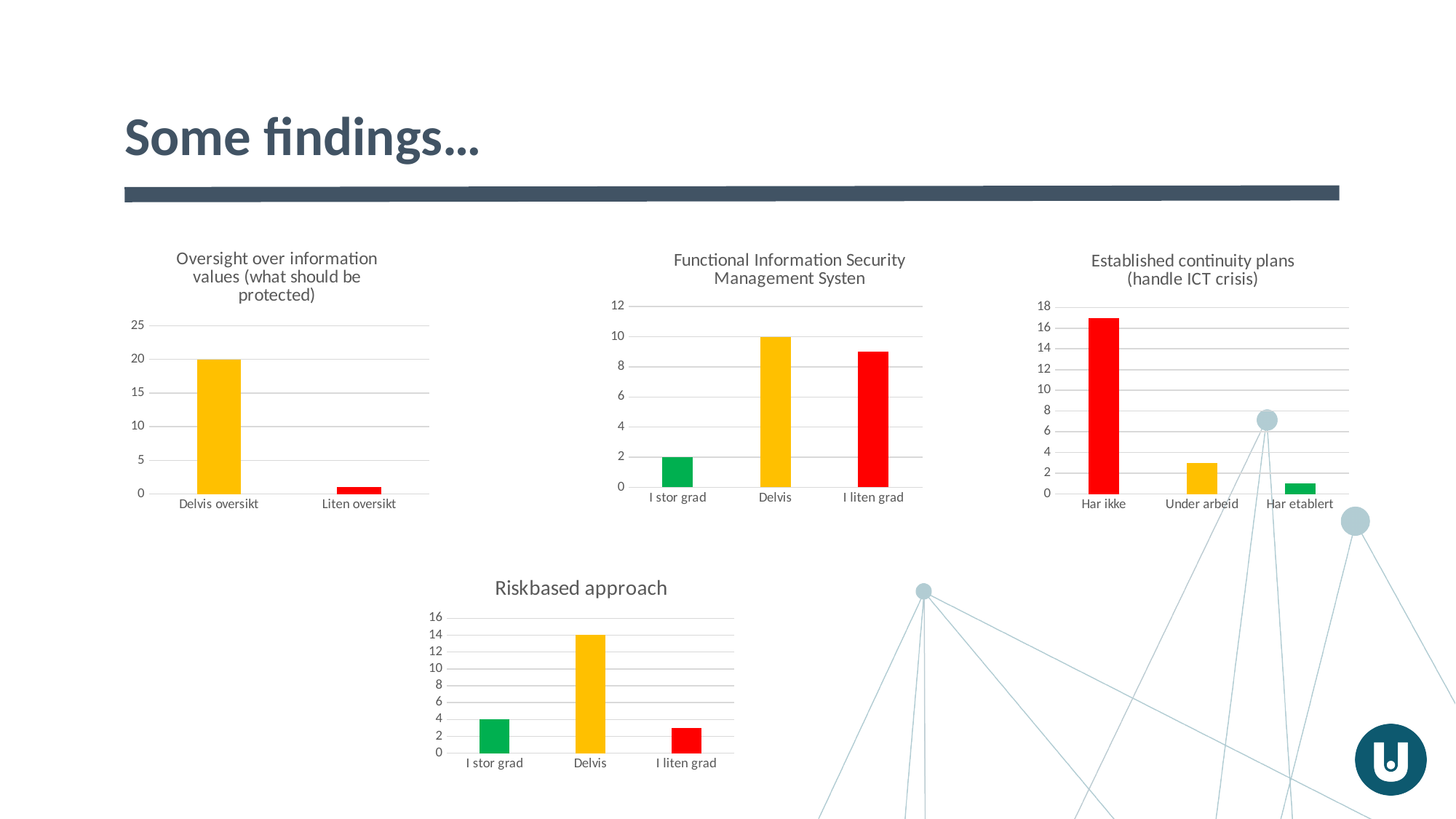
In the 'Established continuity plans' chart, how many categories are shown? 3 In the 'Riskbased approach' chart, what is the difference between Delvis and I stor grad? 10 What kind of chart is the 'Riskbased approach' chart? bar chart In the 'Established continuity plans' chart, is the value for Har ikke greater or less than 16? greater In the 'Functional Information Security Management System' chart, what is the value for Delvis? 10 In the 'Established continuity plans' chart, which category has the highest value? Har ikke In the 'Oversight over information values' chart, is the value for Liten oversikt greater or less than 5? less In the 'Oversight over information values' chart, what is the value for Delvis oversikt? 20 In the 'Functional Information Security Management System' chart, is the value for I liten grad greater or less than 8? greater In the 'Functional Information Security Management System' chart, which category has the lowest value? I stor grad In the 'Functional Information Security Management System' chart, what is the value for I stor grad? 2 In the 'Riskbased approach' chart, what is the value for Delvis? 14